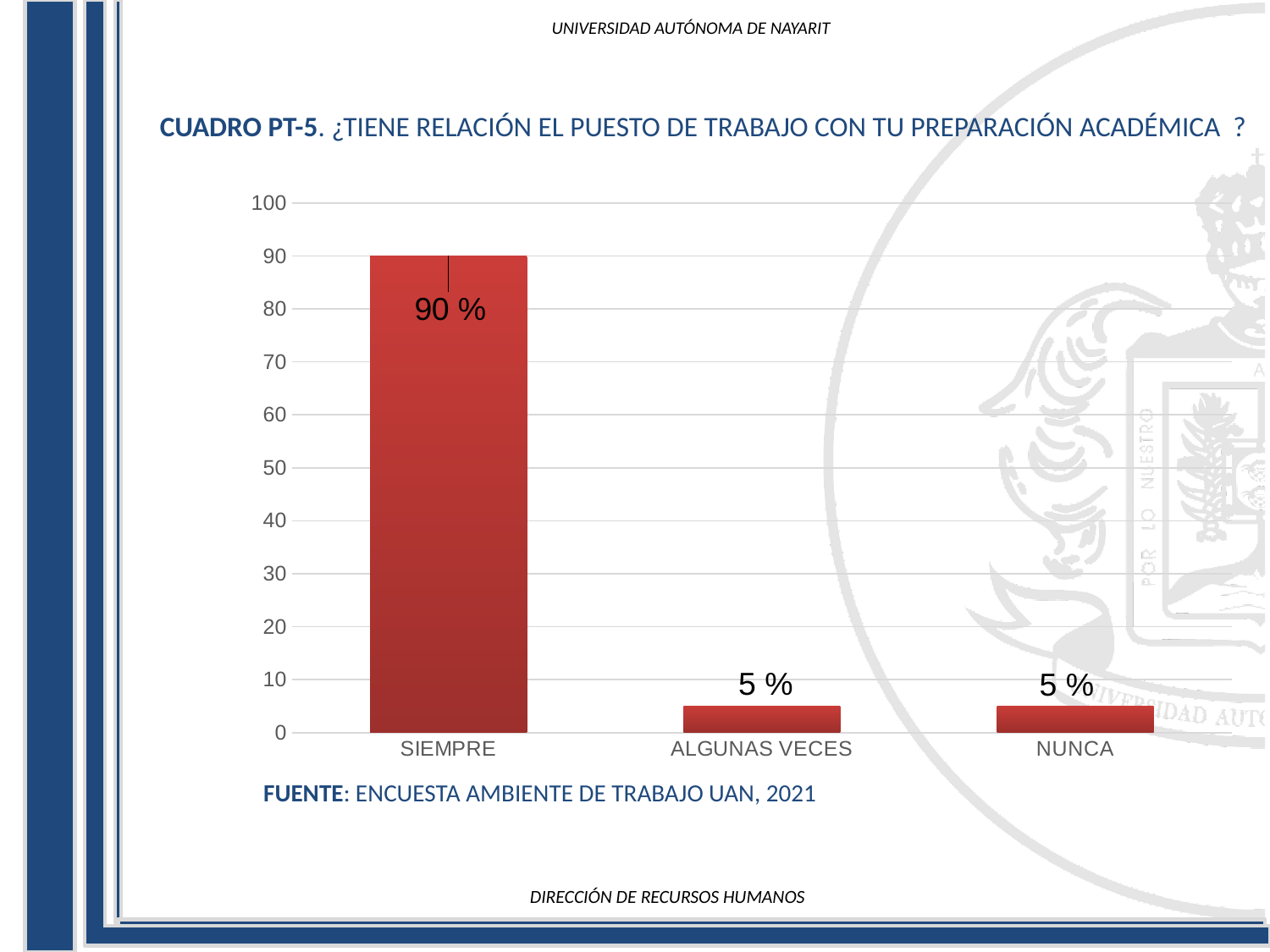
What is the value for NUNCA? 5 % How many categories are shown on the x axis? 3 What is the difference between the values for SIEMPRE and NUNCA? 85 % What kind of chart is shown on the slide? bar chart Is the value for SIEMPRE greater or less than 50? greater Which category has the highest value? SIEMPRE What is the value for SIEMPRE? 90 % Is the value for NUNCA greater or less than 10? less What is the highest value shown on the y axis? 100 Which is larger, the value for SIEMPRE or the value for ALGUNAS VECES? SIEMPRE What is the source cited below the chart? ENCUESTA AMBIENTE DE TRABAJO UAN, 2021 What is the value for ALGUNAS VECES? 5 %